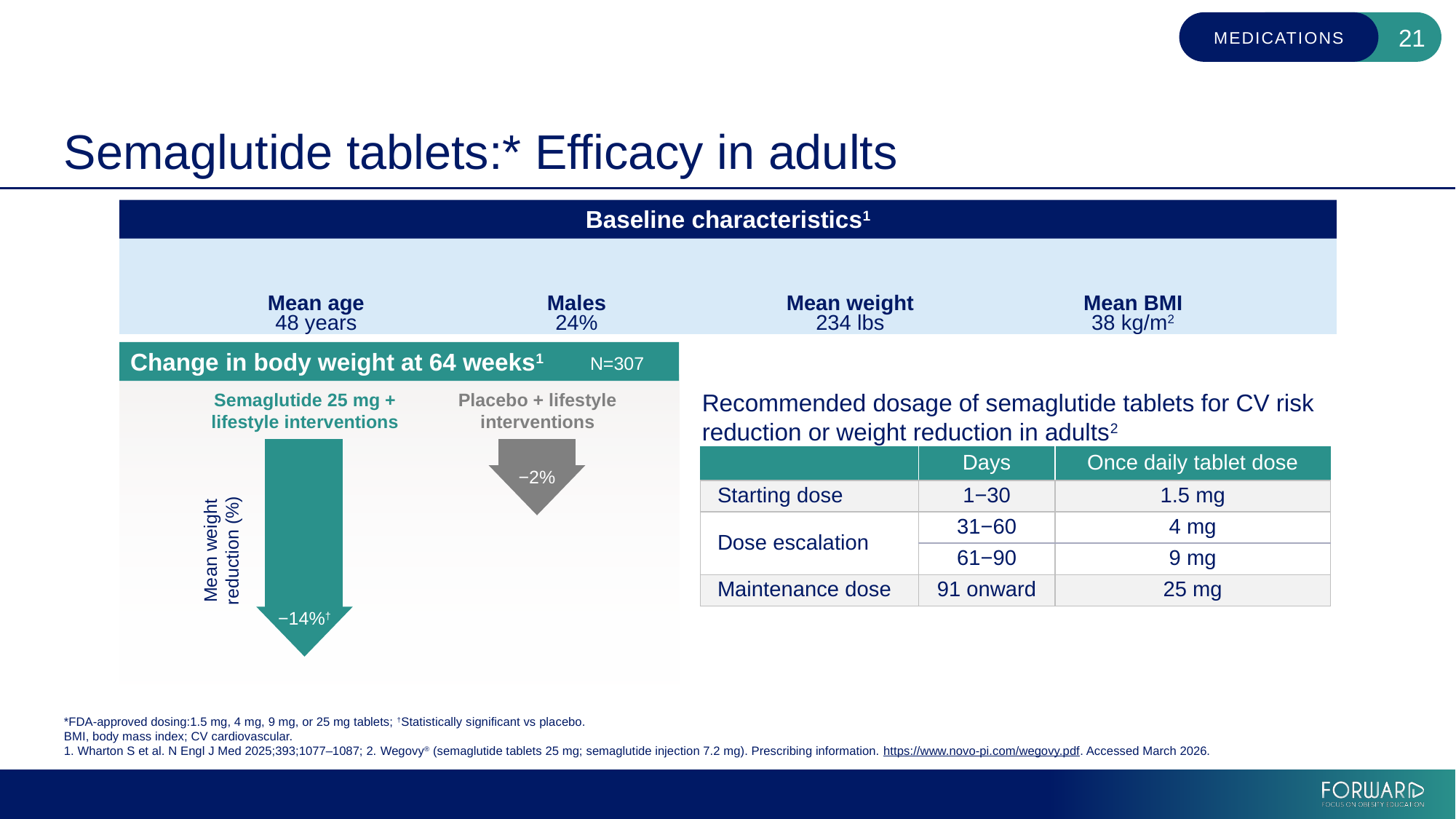
In the 'Change in body weight at 64 weeks' chart, which group shows the larger weight reduction? Semaglutide 25 mg + lifestyle interventions What is the N value shown in the header of the 'Change in body weight at 64 weeks' chart? N=307 In the 'Change in body weight at 64 weeks' chart, is the weight reduction greater for the semaglutide group or the placebo group? Semaglutide group In the 'Change in body weight at 64 weeks' chart, what is the mean weight reduction for semaglutide 25 mg + lifestyle interventions? −14% In the 'Change in body weight at 64 weeks' chart, which group shows the smaller weight reduction? Placebo + lifestyle interventions What kind of chart is used to show the change in body weight at 64 weeks? Bar chart In the 'Change in body weight at 64 weeks' chart, what is the mean weight reduction for placebo + lifestyle interventions? −2% What is the y-axis label of the 'Change in body weight at 64 weeks' chart? Mean weight reduction (%) How many treatment groups are shown in the 'Change in body weight at 64 weeks' chart? 2 In the 'Change in body weight at 64 weeks' chart, what is the difference in percentage points between the semaglutide and placebo weight reductions? 12 percentage points